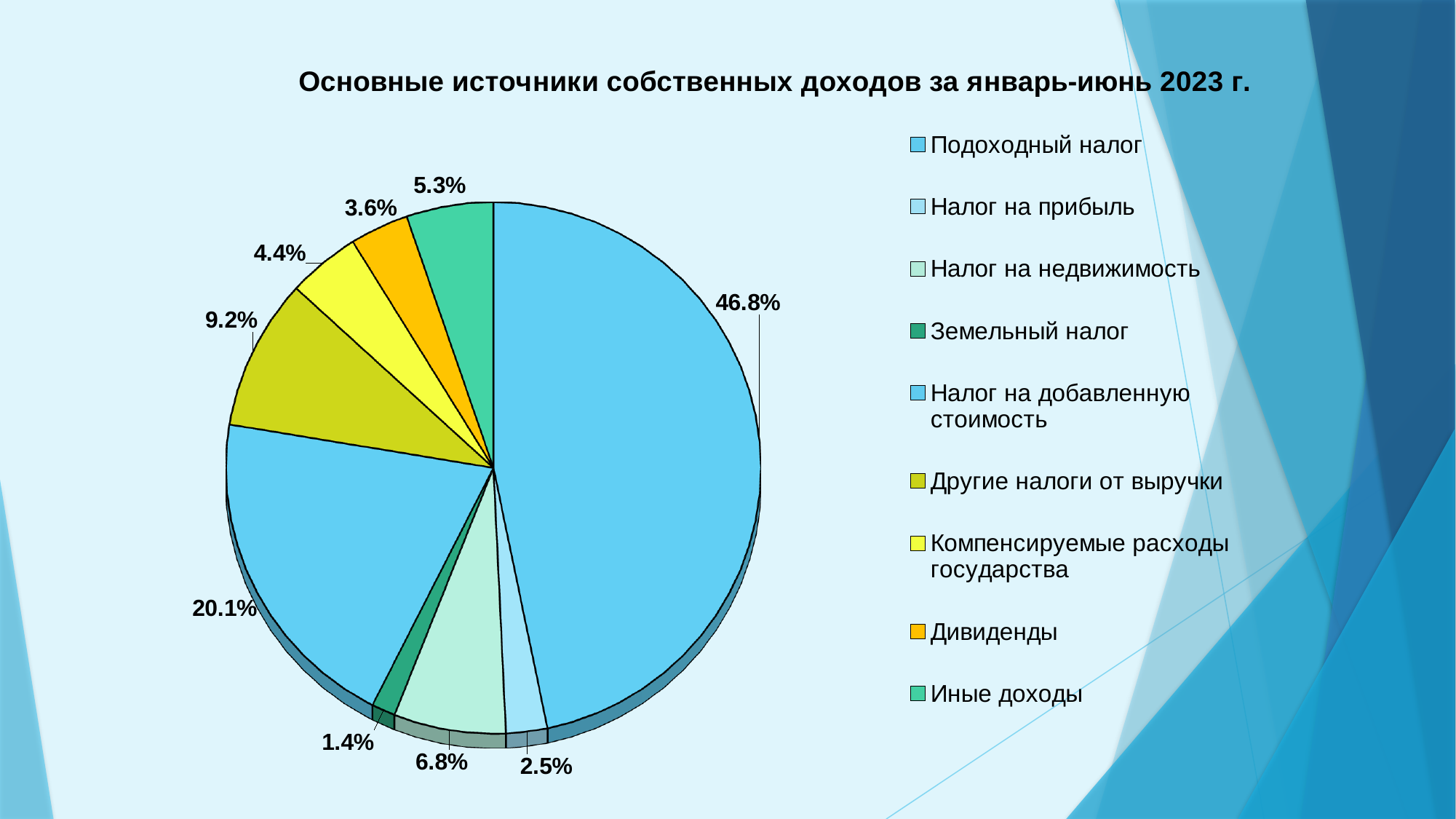
Which is larger: the share of Налог на недвижимость or the share of Иные доходы? Налог на недвижимость What is the difference between the shares of Подоходный налог and Налог на добавленную стоимость? 26.7% What is the share of Другие налоги от выручки? 9.2% What is the share of Дивиденды? 3.6% What is the share of Подоходный налог in the pie chart? 46.8% What is the title of the chart? Основные источники собственных доходов за январь-июнь 2023 г. How many categories does the legend list? 9 Which category has the smallest share of the pie? Земельный налог What is the share of Земельный налог? 1.4% Which category has the largest share of the pie? Подоходный налог What is the share of Налог на добавленную стоимость? 20.1% What kind of chart is shown on the slide? pie chart